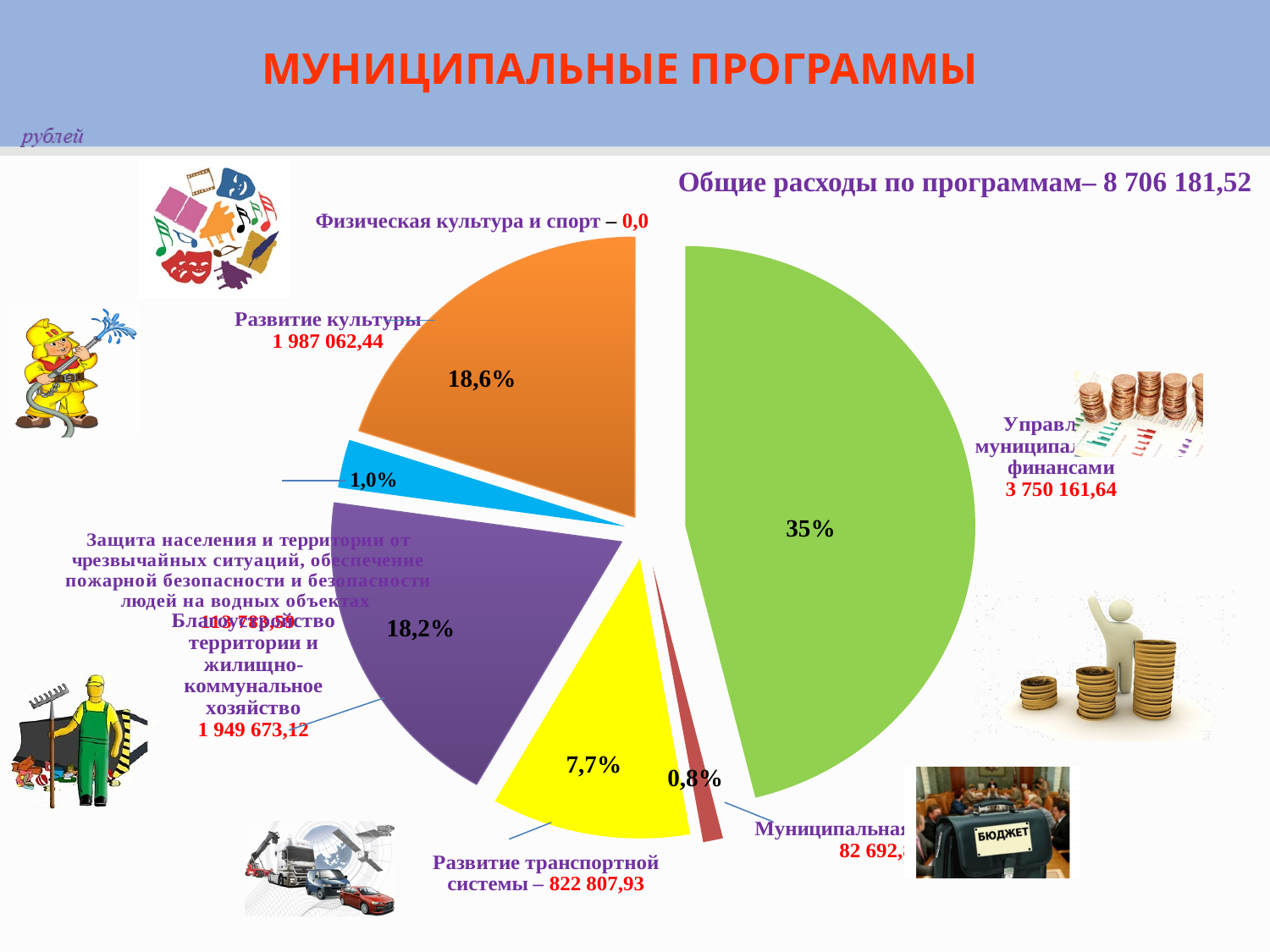
What share of the pie does Развитие транспортной системы take? 7,7% Which program has the largest slice of the pie? Управление муниципальными финансами What is the value for Развитие транспортной системы? 822 807,93 What are the total expenses on programs stated on the slide? 8 706 181,52 What kind of chart is shown on the slide? pie chart What share of the pie does Управление муниципальными финансами take? 35% What is the value for Благоустройство территории и жилищно-коммунальное хозяйство? 1 949 673,12 What is the value for Физическая культура и спорт? 0,0 What is the value for Управление муниципальными финансами? 3 750 161,64 What share of the pie does Развитие культуры take? 18,6% What is the value for Развитие культуры? 1 987 062,44 Which is larger: Развитие культуры or Благоустройство территории и жилищно-коммунальное хозяйство? Развитие культуры